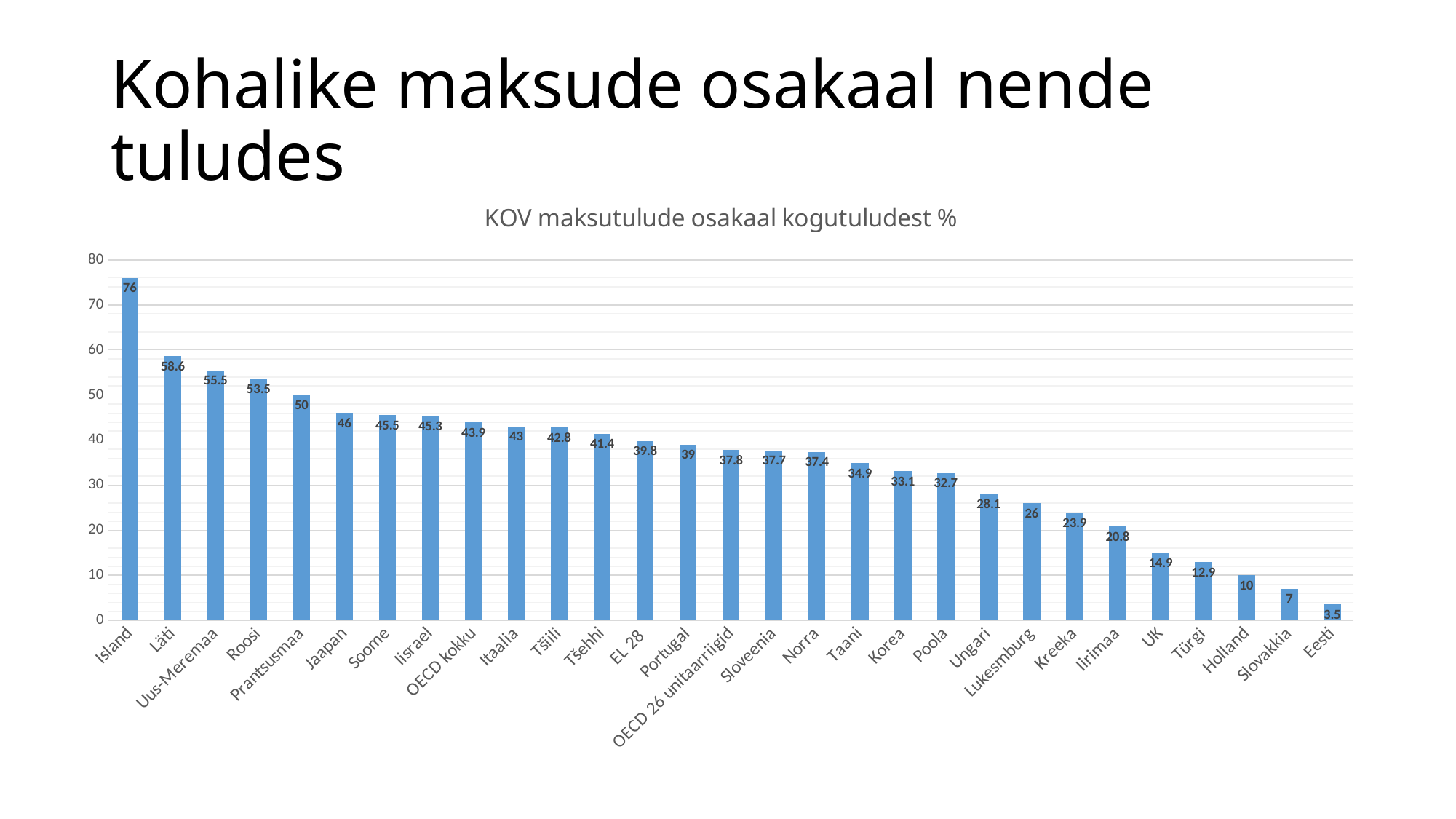
Is the value for Ungari greater or less than 30? less What is the value for OECD kokku? 43.9 What is the value for Island? 76 How many categories are shown on the x axis? 29 Which category has the highest value? Island What is the title of the chart? KOV maksutulude osakaal kogutuludest % What is the difference between the values for Island and Läti? 17.4 What is the value for EL 28? 39.8 Which is larger, the value for Soome or the value for Norra? Soome What is the value for Eesti? 3.5 Which category has the lowest value? Eesti What kind of chart is shown? bar chart